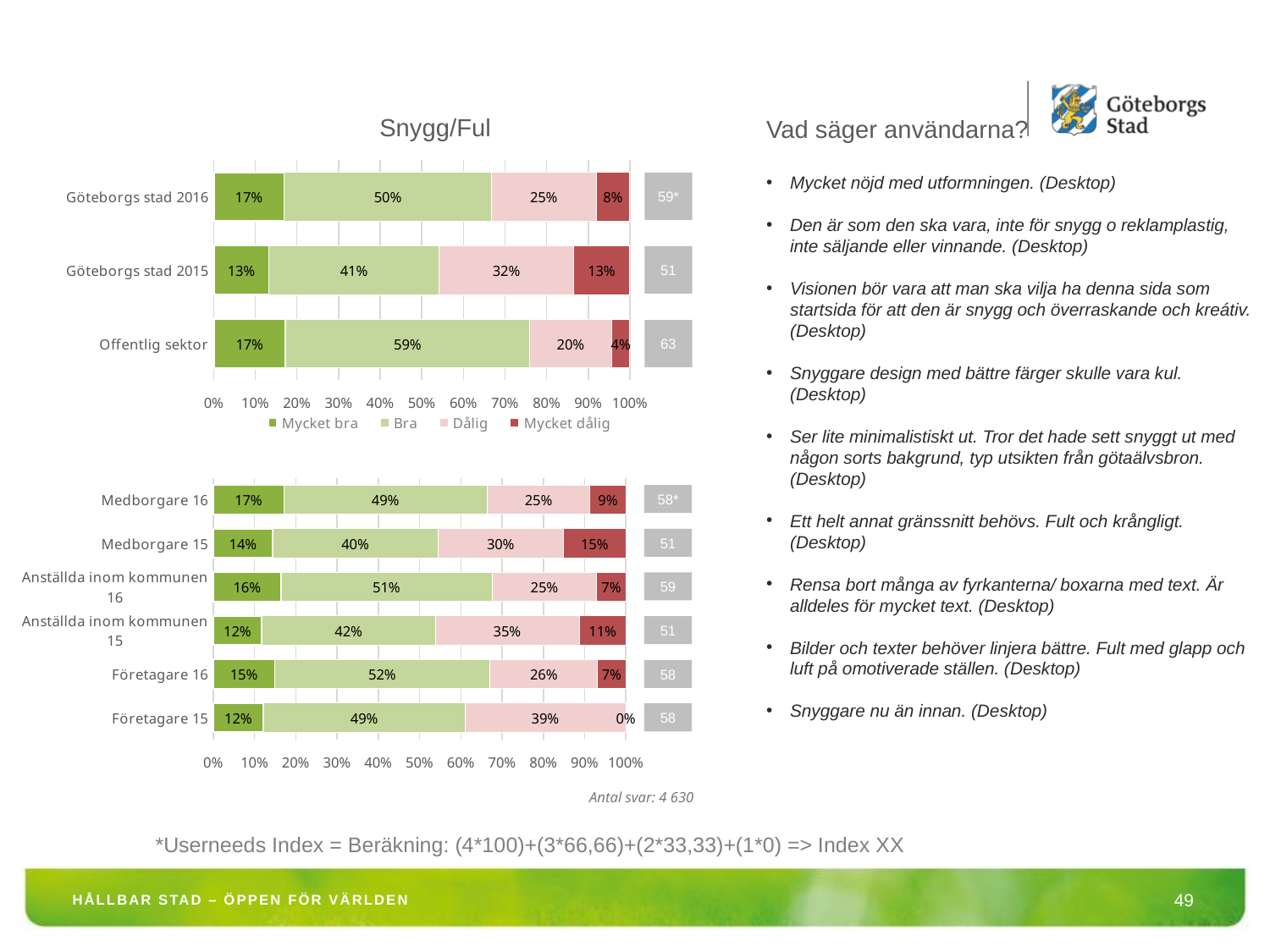
In the lower chart, what is the Dålig value for Företagare 15? 39% In the lower chart, what is the Mycket bra value for Anställda inom kommunen 16? 16% In the lower chart, how many categories are shown? 6 In the top chart titled Snygg/Ful, which category has the highest Bra value? Offentlig sektor In the top chart titled Snygg/Ful, what is the difference between the Dålig values for Göteborgs stad 2015 and Göteborgs stad 2016? 7% In the lower chart, which category has the highest Mycket dålig value? Medborgare 15 In the top chart titled Snygg/Ful, what is the Mycket dålig value for Göteborgs stad 2015? 13% In the top chart titled Snygg/Ful, how many categories are shown? 3 What kind of chart is the top chart titled Snygg/Ful? Stacked bar chart In the lower chart, which is larger: the Bra value for Företagare 16 or the Bra value for Medborgare 15? Företagare 16 In the top chart titled Snygg/Ful, what is the Bra value for Offentlig sektor? 59% In the top chart titled Snygg/Ful, how many series does the legend list? 4